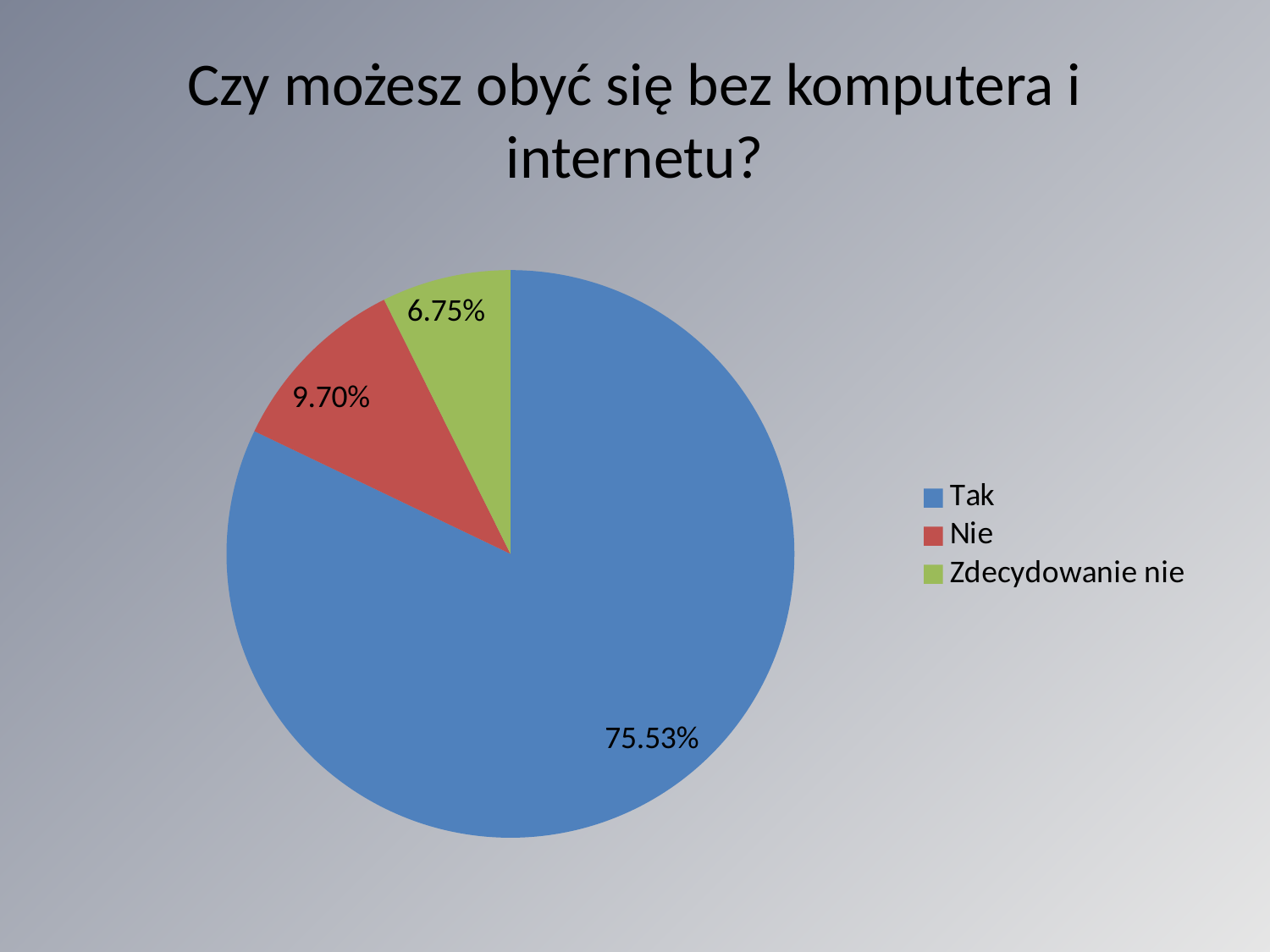
What percentage of the pie is the "Tak" slice? 75.53% What colour is the "Tak" slice? blue What kind of chart is shown on the slide? pie chart Which slice is larger, "Nie" or "Zdecydowanie nie"? Nie What percentage of the pie is the "Nie" slice? 9.70% What is the difference between the "Tak" and "Nie" slices? 65.83% What percentage of the pie is the "Zdecydowanie nie" slice? 6.75% What is the difference between the "Nie" and "Zdecydowanie nie" slices? 2.95% Which category has the largest slice of the pie? Tak What is the title of the chart? Czy możesz obyć się bez komputera i internetu? Which category has the smallest slice of the pie? Zdecydowanie nie How many categories does the legend list? 3